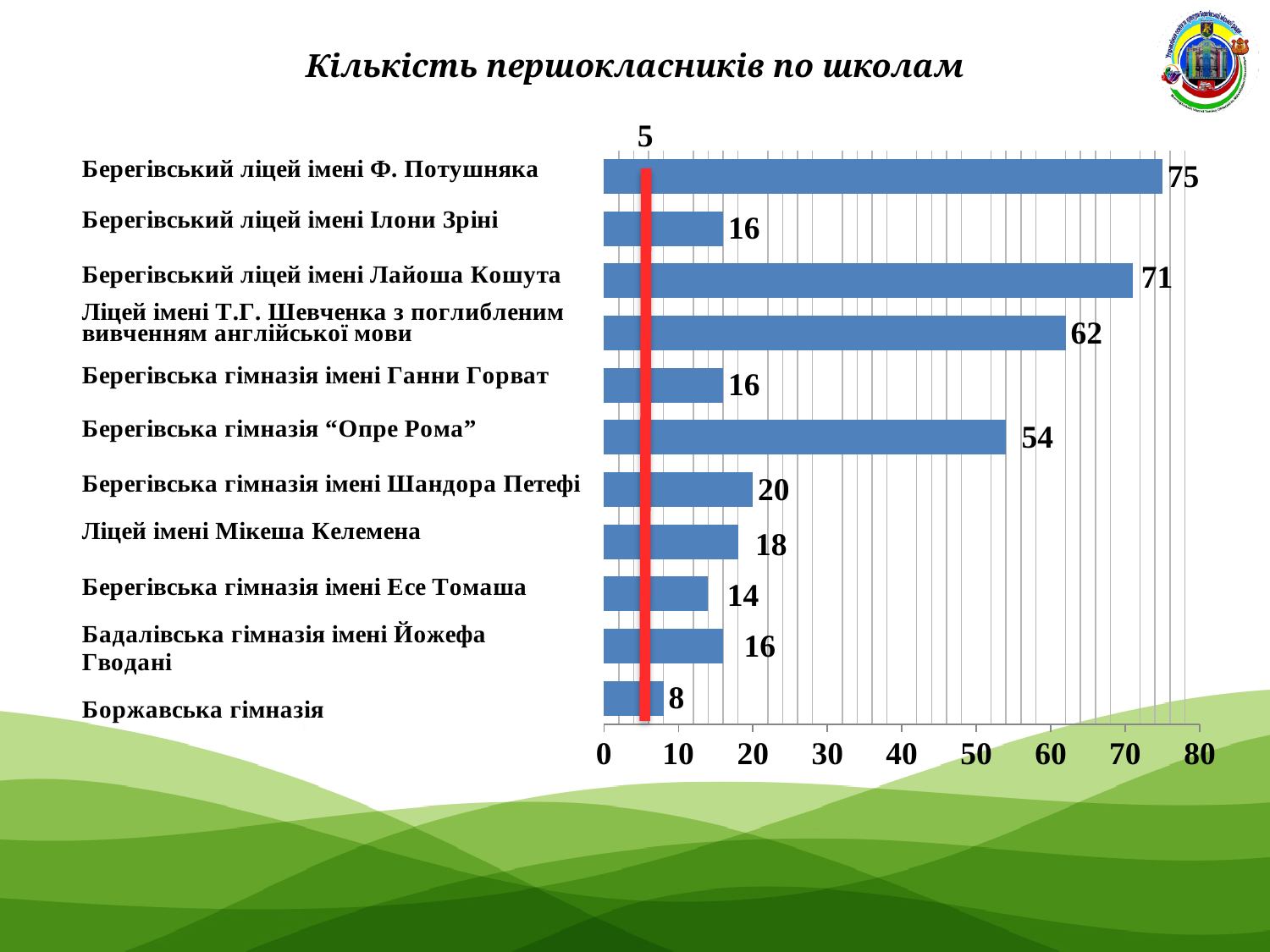
How many schools are shown in the chart? 11 What value is marked by the red vertical line on the chart? 5 What is the value for Боржавська гімназія? 8 What is the value for Ліцей імені Мікеша Келемена? 18 What type of chart is shown on the slide? bar chart Which school has the lowest number of first-graders? Боржавська гімназія What is the title of the chart? Кількість першокласників по школам What is the value for Берегівська гімназія “Опре Рома”? 54 Which school has the highest number of first-graders? Берегівський ліцей імені Ф. Потушняка Which is larger: the value for Берегівська гімназія імені Шандора Петефі or the value for Берегівська гімназія імені Есе Томаша? Берегівська гімназія імені Шандора Петефі What is the difference between the values for Берегівський ліцей імені Лайоша Кошута and Ліцей імені Т.Г. Шевченка з поглибленим вивченням англійської мови? 9 What is the value for Берегівський ліцей імені Ф. Потушняка? 75